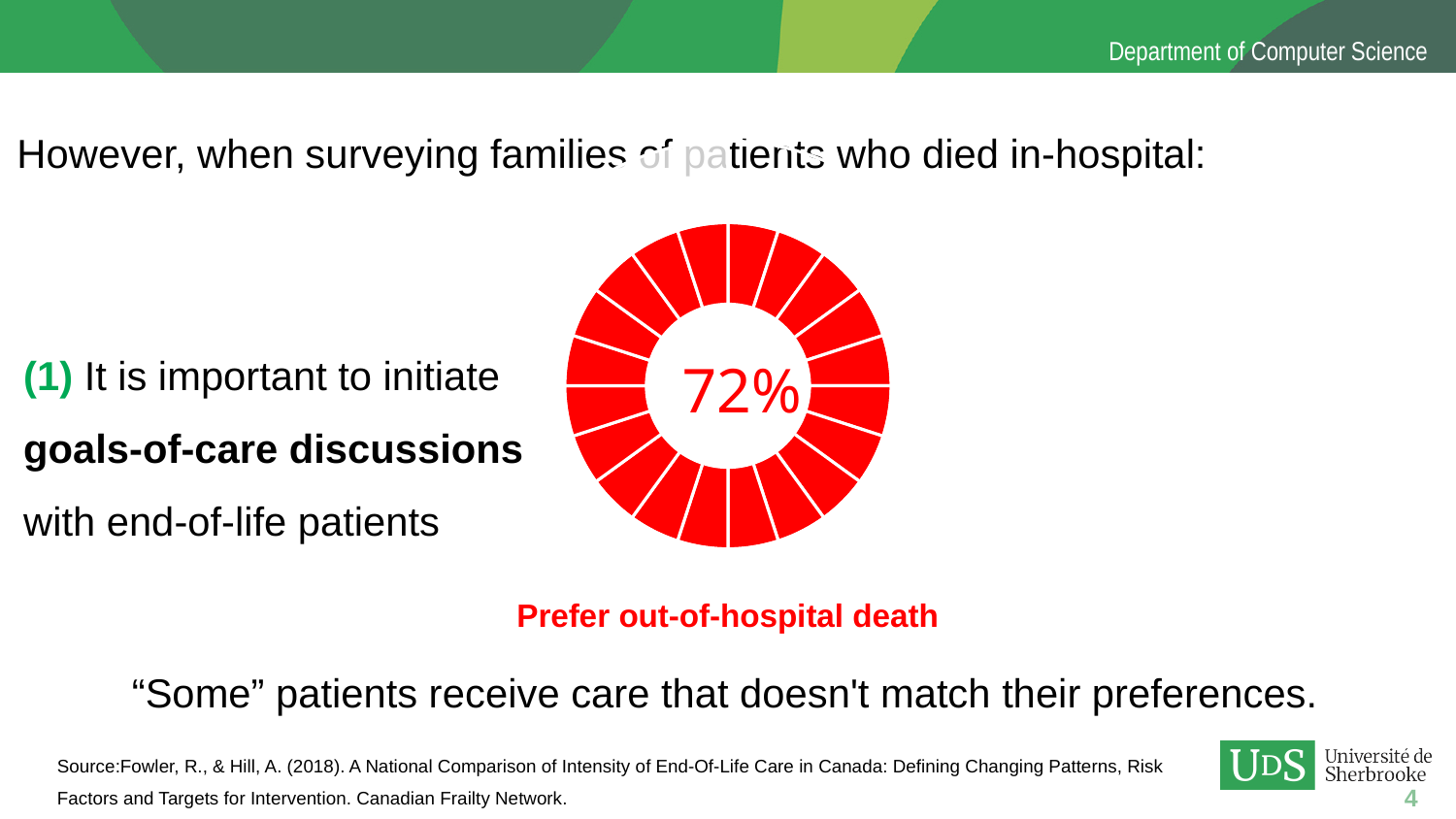
What label appears beneath the donut chart? Prefer out-of-hospital death Is the value shown in the donut chart greater or less than 50%? greater What percentage is shown in the centre of the donut chart? 72% What share of surveyed families prefer out-of-hospital death, according to the chart? 72% What kind of chart is shown on the slide? Donut (pie) chart What colour are the segments of the donut chart? Red